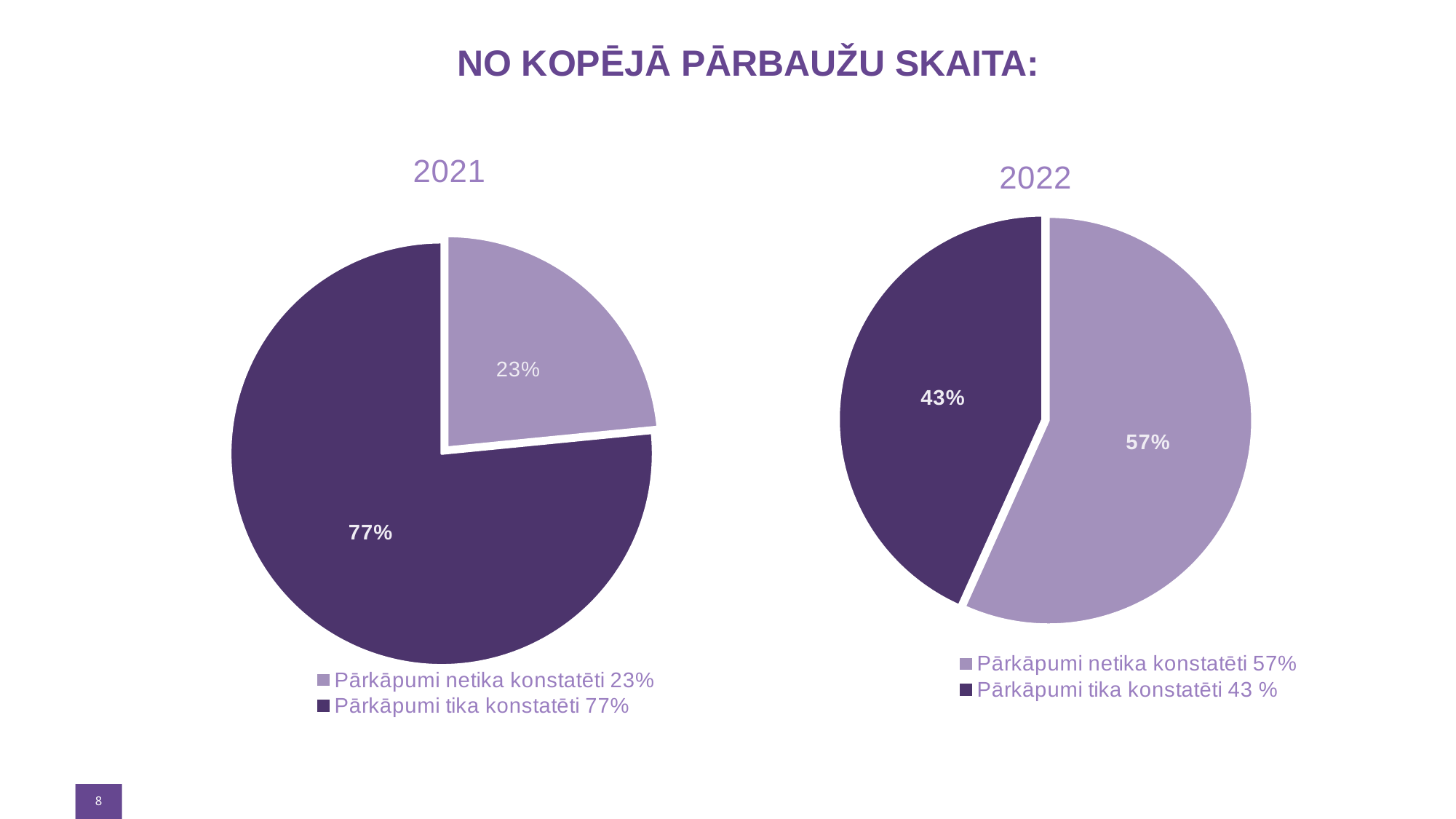
In the 2021 chart, what is the difference between the two slices' percentages? 54% In the 2021 chart, which slice is the largest? Pārkāpumi tika konstatēti What kind of chart is the 2021 chart? Pie chart In the 2022 chart, which slice is larger: 'Pārkāpumi netika konstatēti' or 'Pārkāpumi tika konstatēti'? Pārkāpumi netika konstatēti In the 2022 chart, what share of the pie is labelled 'Pārkāpumi netika konstatēti'? 57% In the 2022 chart, which slice is the smallest? Pārkāpumi tika konstatēti In the 2022 chart, what share of the pie is labelled 'Pārkāpumi tika konstatēti'? 43% How many slices does the 2022 chart have? 2 In the 2021 chart, what share of the pie is labelled 'Pārkāpumi tika konstatēti'? 77% What is the title of the chart on the right? 2022 In the 2022 chart, what is the difference between the two slices' percentages? 14%